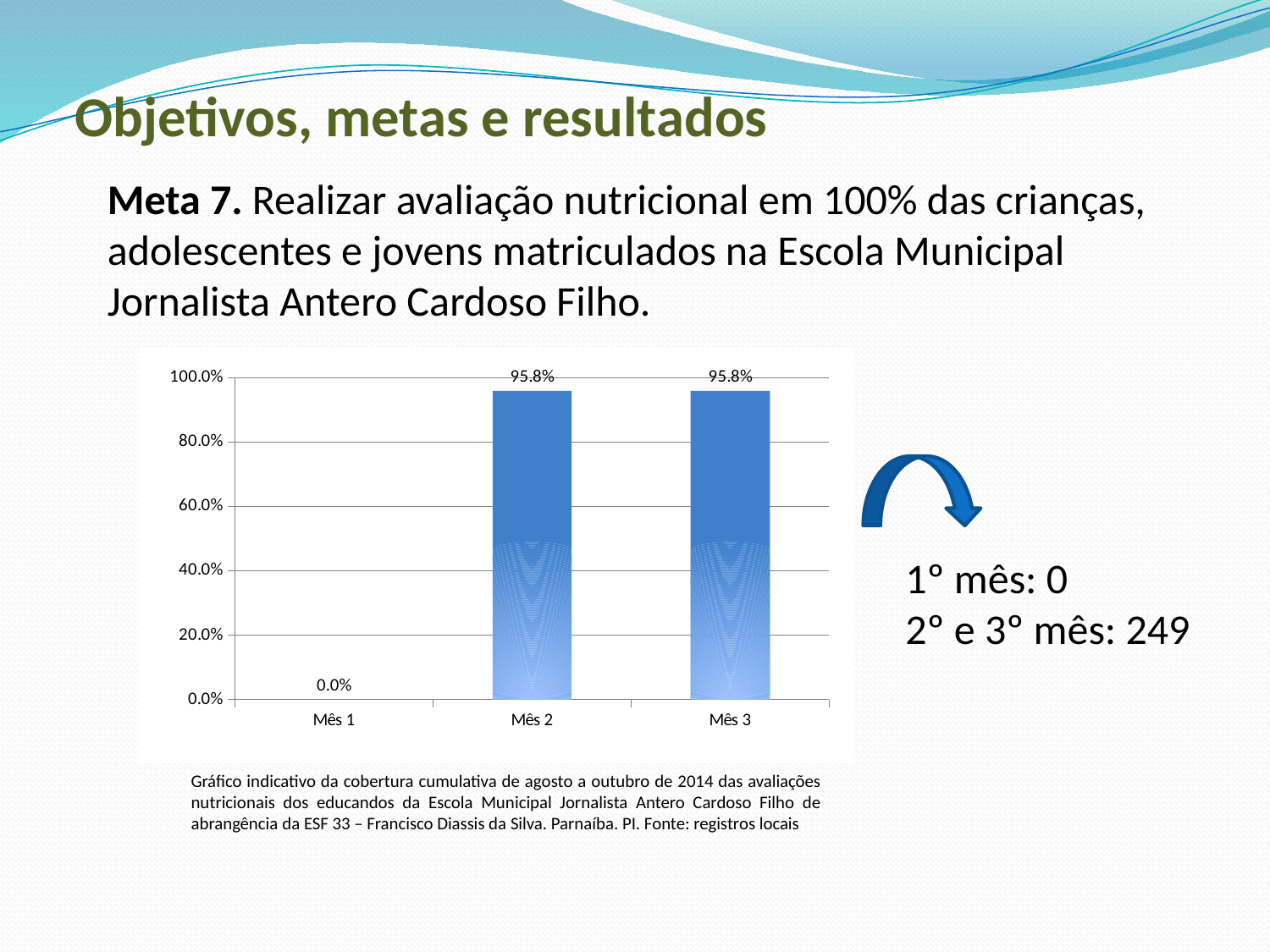
What is the difference between the values for Mês 2 and Mês 1? 95.8% Is the value for Mês 2 greater or less than 80.0%? greater Do the values rise or fall from Mês 1 to Mês 2? rise What is the value for Mês 2? 95.8% What kind of chart is shown? bar chart What is the value for Mês 3? 95.8% Which is larger, the value for Mês 1 or the value for Mês 3? Mês 3 What is the value for Mês 1? 0.0% Which category has the lowest value? Mês 1 How many categories are shown on the x axis? 3 What is the highest value shown on the y axis? 100.0% Is the value for Mês 1 greater or less than 20.0%? less